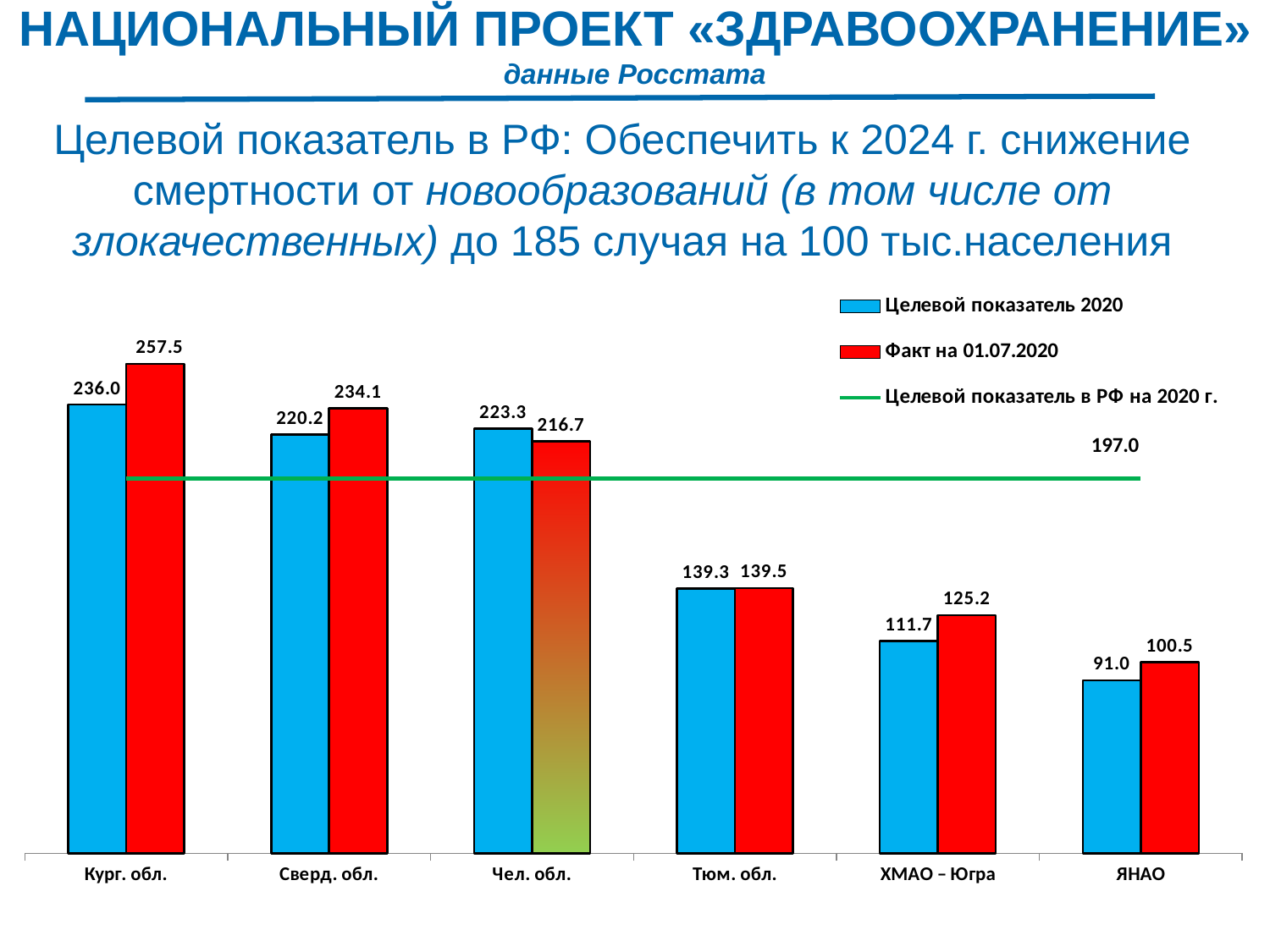
What value is shown for the line «Целевой показатель в РФ на 2020 г.»? 197.0 What colour are the bars for «Факт на 01.07.2020»? Red Which region has the lowest «Целевой показатель 2020» value? ЯНАО What type of chart is shown on the slide? Bar chart What is the difference between «Факт на 01.07.2020» and «Целевой показатель 2020» for Кург. обл.? 21.5 For Чел. обл., which is larger: «Целевой показатель 2020» or «Факт на 01.07.2020»? Целевой показатель 2020 What is the value of «Факт на 01.07.2020» for Кург. обл.? 257.5 What is the value of «Факт на 01.07.2020» for ХМАО – Югра? 125.2 How many regions are shown on the x axis of the chart? 6 Which region has the highest «Факт на 01.07.2020» value? Кург. обл. How many entries does the chart legend list? 3 What is the value of «Целевой показатель 2020» for Сверд. обл.? 220.2